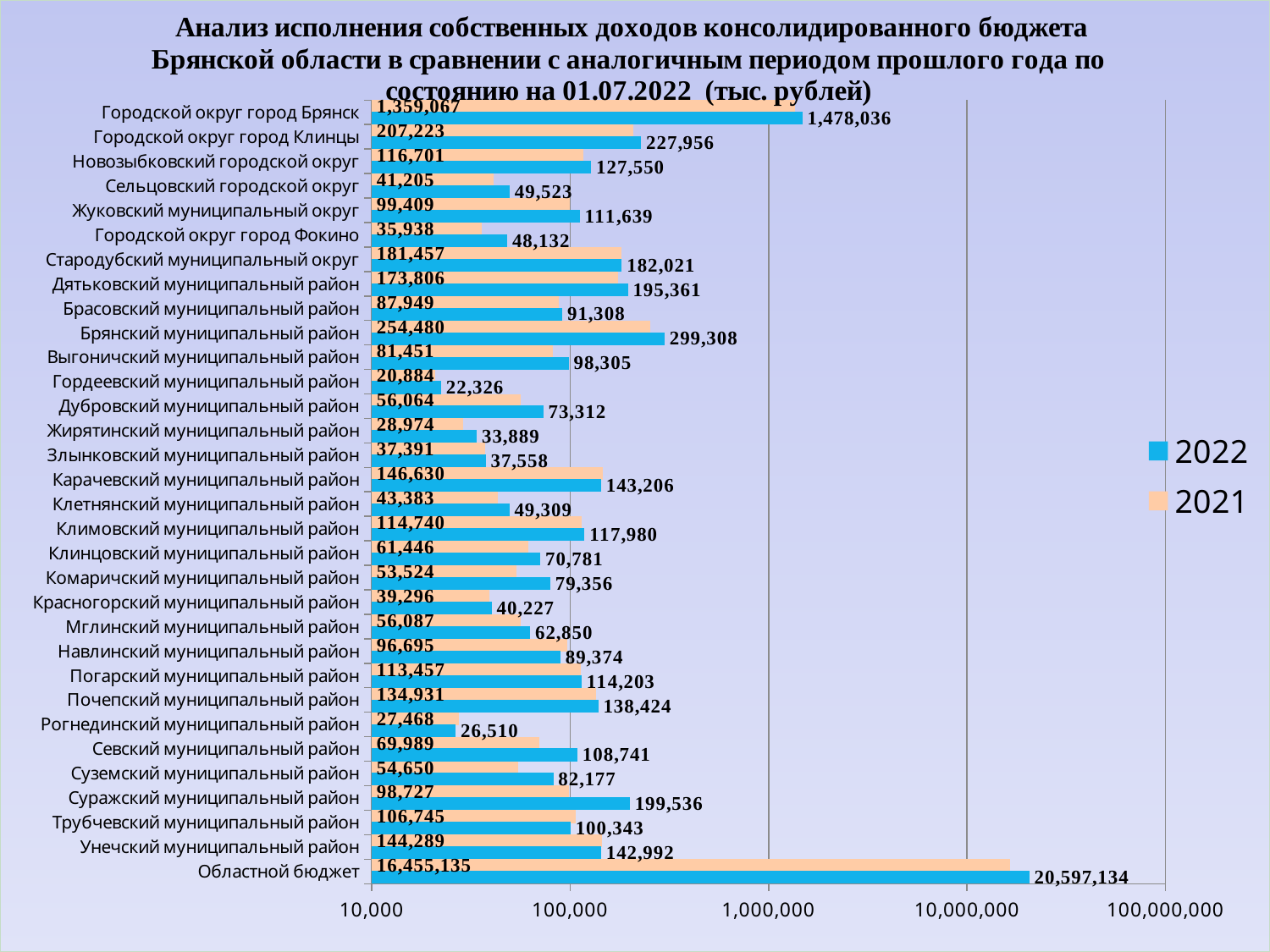
Which category has the highest 2022 value? Областной бюджет What kind of chart is shown on the slide? Bar chart What is the 2022 value for Городской округ город Брянск? 1,478,036 What is the difference between the 2022 and 2021 values for Городской округ город Брянск? 118,969 What is the 2022 value for Суражский муниципальный район? 199,536 How many series does the legend list? 2 Which category has the lowest 2022 value? Гордеевский муниципальный район For Севский муниципальный район, which year has the larger value, 2022 or 2021? 2022 How many categories are shown on the chart? 32 For Навлинский муниципальный район, which year has the larger value, 2022 or 2021? 2021 What is the 2021 value for Областной бюджет? 16,455,135 What is the difference between the 2022 and 2021 values for Сельцовский городской округ? 8,318